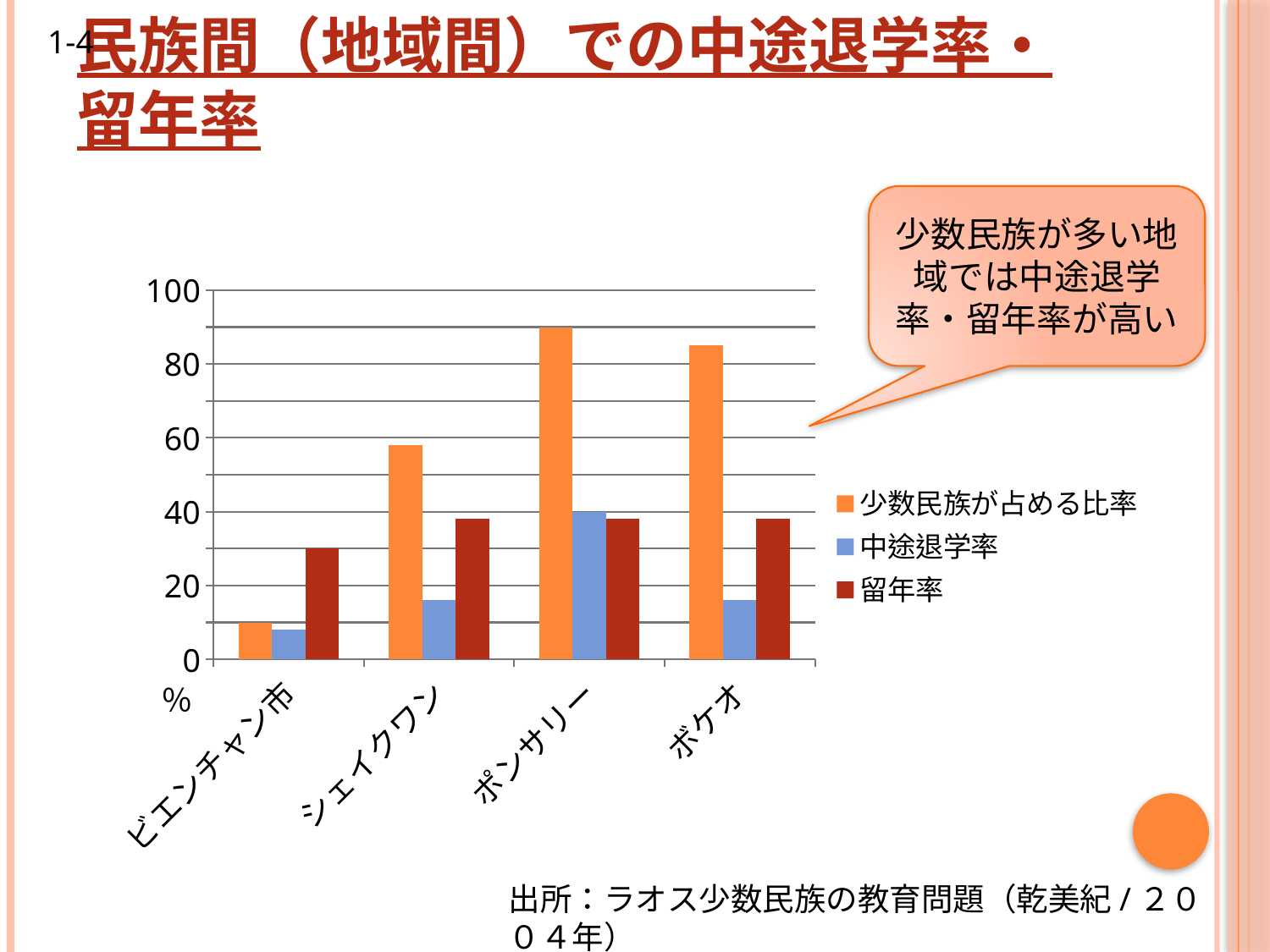
Which region has the lowest 留年率? ビエンチャン市 Which region has the lowest value for 少数民族が占める比率? ビエンチャン市 In ビエンチャン市, which is larger: 留年率 or 中途退学率? 留年率 Is the 中途退学率 value for ボケオ greater or less than 20? less Is the 少数民族が占める比率 value for ボケオ greater or less than 80? greater Which region has the highest value for 少数民族が占める比率? ポンサリー Which region has the highest 中途退学率? ポンサリー How many regions (categories) are shown on the x axis of the chart? 4 Is the 少数民族が占める比率 value for シェイクワン greater or less than 40? greater Which legend entry is shown in orange? 少数民族が占める比率 What kind of chart is shown on the slide? bar chart How many series does the chart's legend list? 3